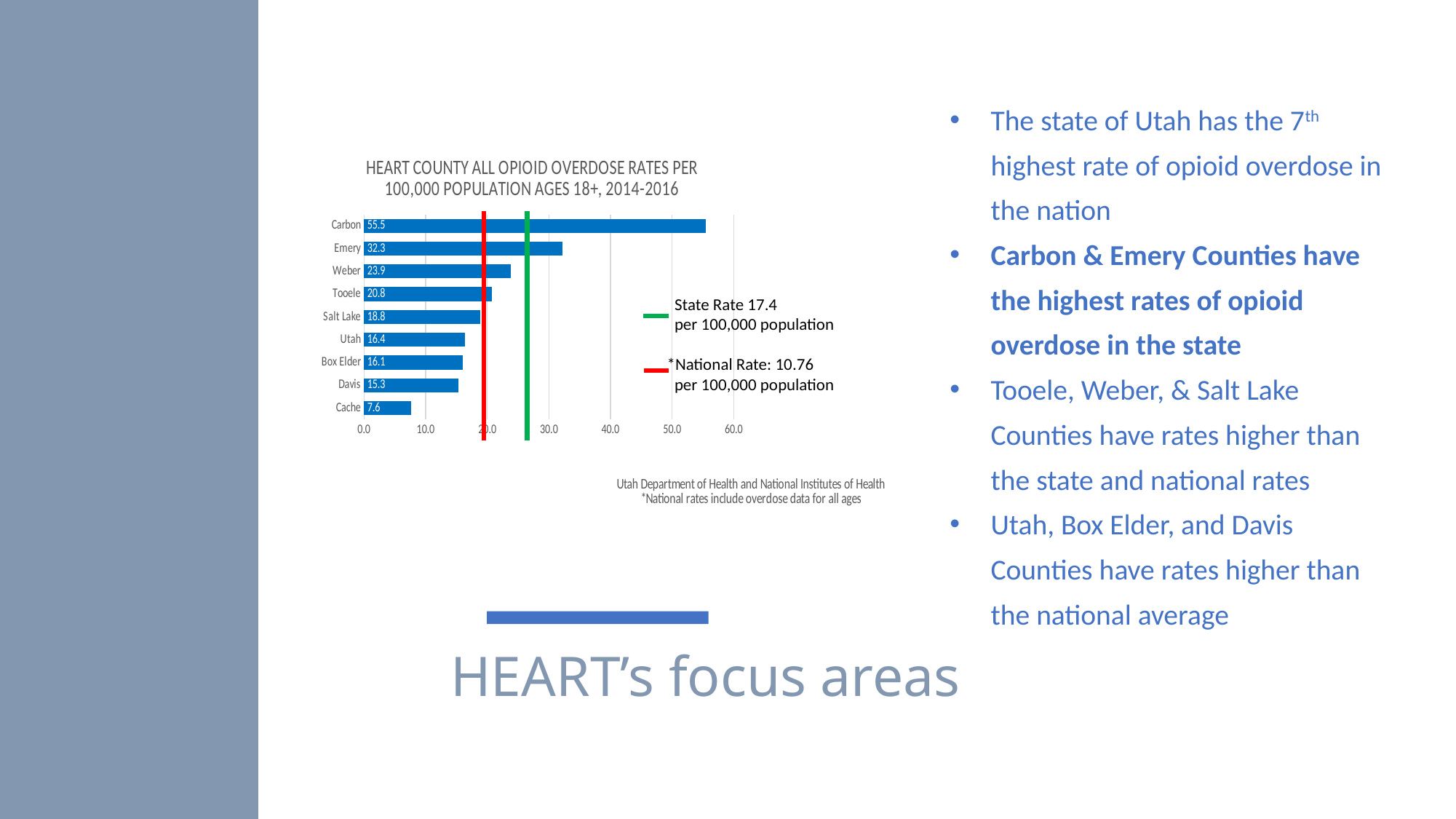
Which county has the highest opioid overdose rate? Carbon What type of chart is shown on the slide? bar chart What is the opioid overdose rate for Carbon County? 55.5 What is the opioid overdose rate for Cache County? 7.6 What is the opioid overdose rate for Tooele County? 20.8 What is the difference between the rates for Weber and Davis counties? 8.6 Is the value for Emery greater or less than 30.0? greater Which has a higher opioid overdose rate, Salt Lake or Utah County? Salt Lake How many counties are shown in the chart? 9 Which county has the lowest opioid overdose rate? Cache What is the difference between the rates for Carbon and Emery counties? 23.2 What state rate is marked by the green line on the chart? 17.4 per 100,000 population